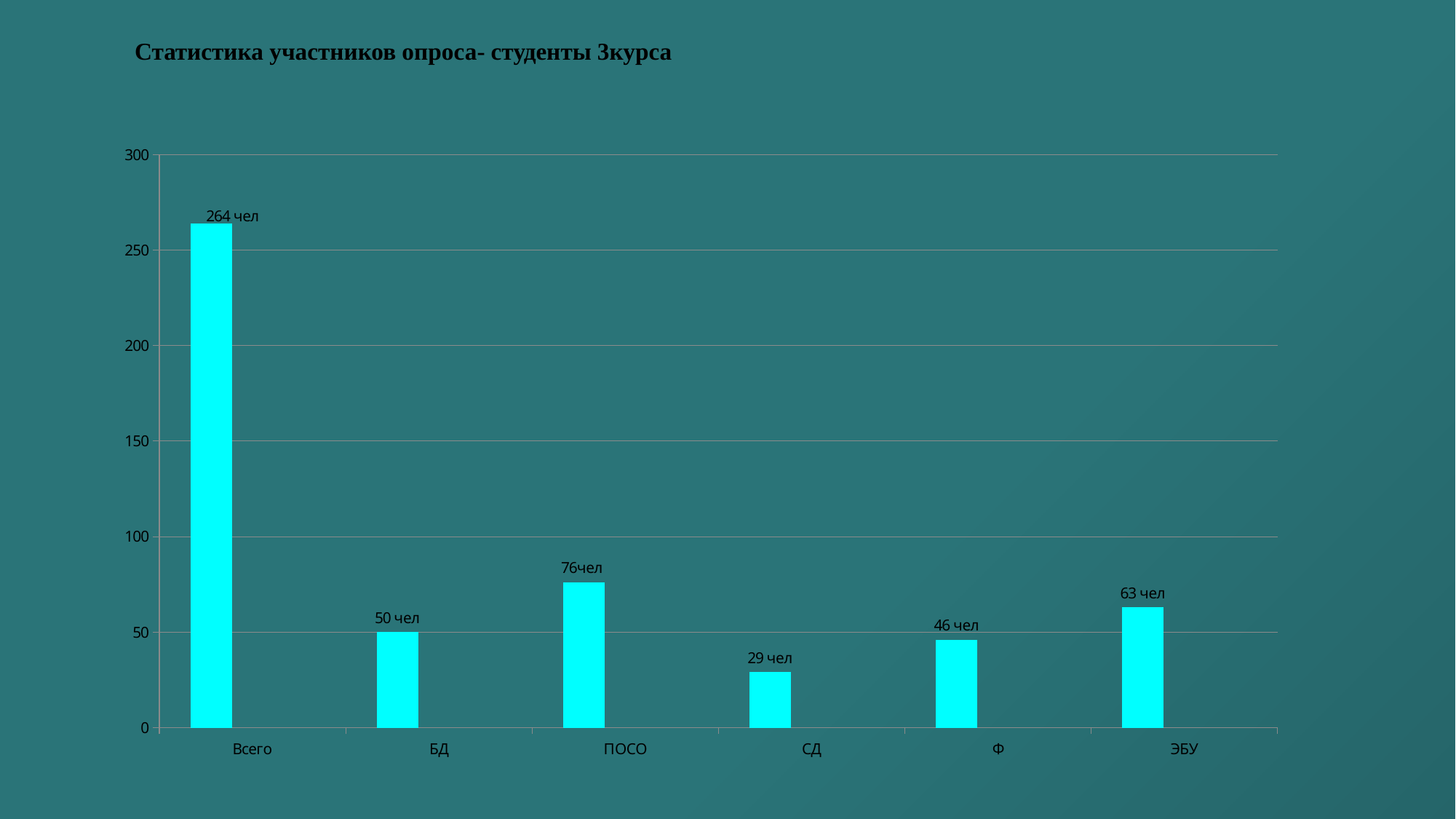
What kind of chart is this? bar chart Which category has the lowest value? СД What is the difference between the values for ПОСО and Ф? 30 What is the value for Всего? 264 чел What is the value for ЭБУ? 63 чел What is the title of the chart? Статистика участников опроса- студенты 3курса Which category has the highest value? Всего What is the value for ПОСО? 76чел How many categories are shown on the x axis? 6 What is the value for СД? 29 чел What is the value for БД? 50 чел Which is larger, the value for ЭБУ or the value for БД? ЭБУ